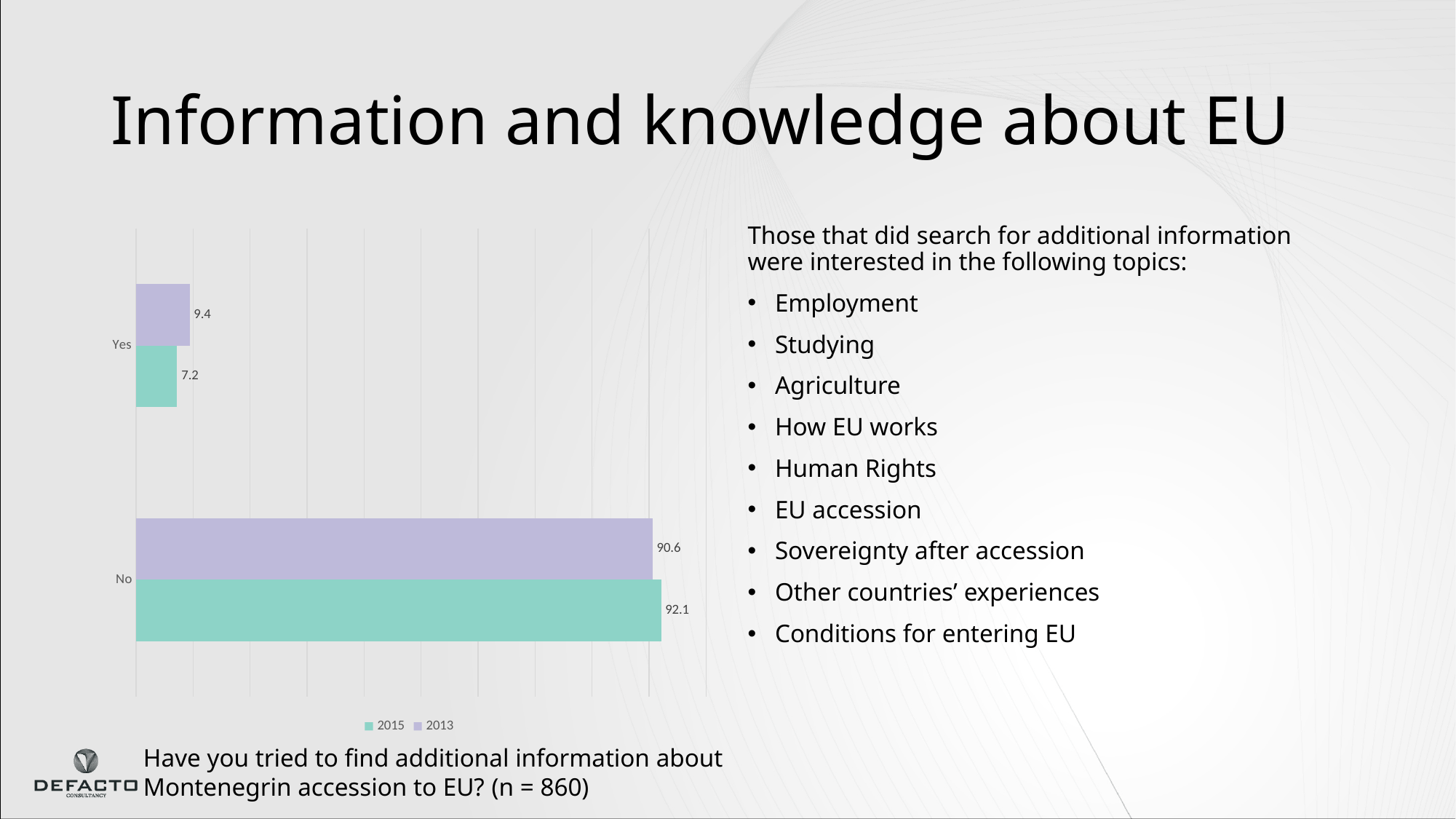
What is the difference between the 2013 and 2015 values for "Yes"? 2.2 Which is larger for "Yes": the 2015 value or the 2013 value? 2013 How many categories are shown on the chart? 2 Which category has the highest value in the 2015 series? No What kind of chart is shown on the slide? Bar chart What is the value for "Yes" in the 2015 series? 7.2 Which category has the lowest value in the 2013 series? Yes What is the value for "No" in the 2013 series? 90.6 What is the value for "Yes" in the 2013 series? 9.4 What is the value for "No" in the 2015 series? 92.1 How many series does the legend list? 2 What is the difference between the 2015 and 2013 values for "No"? 1.5